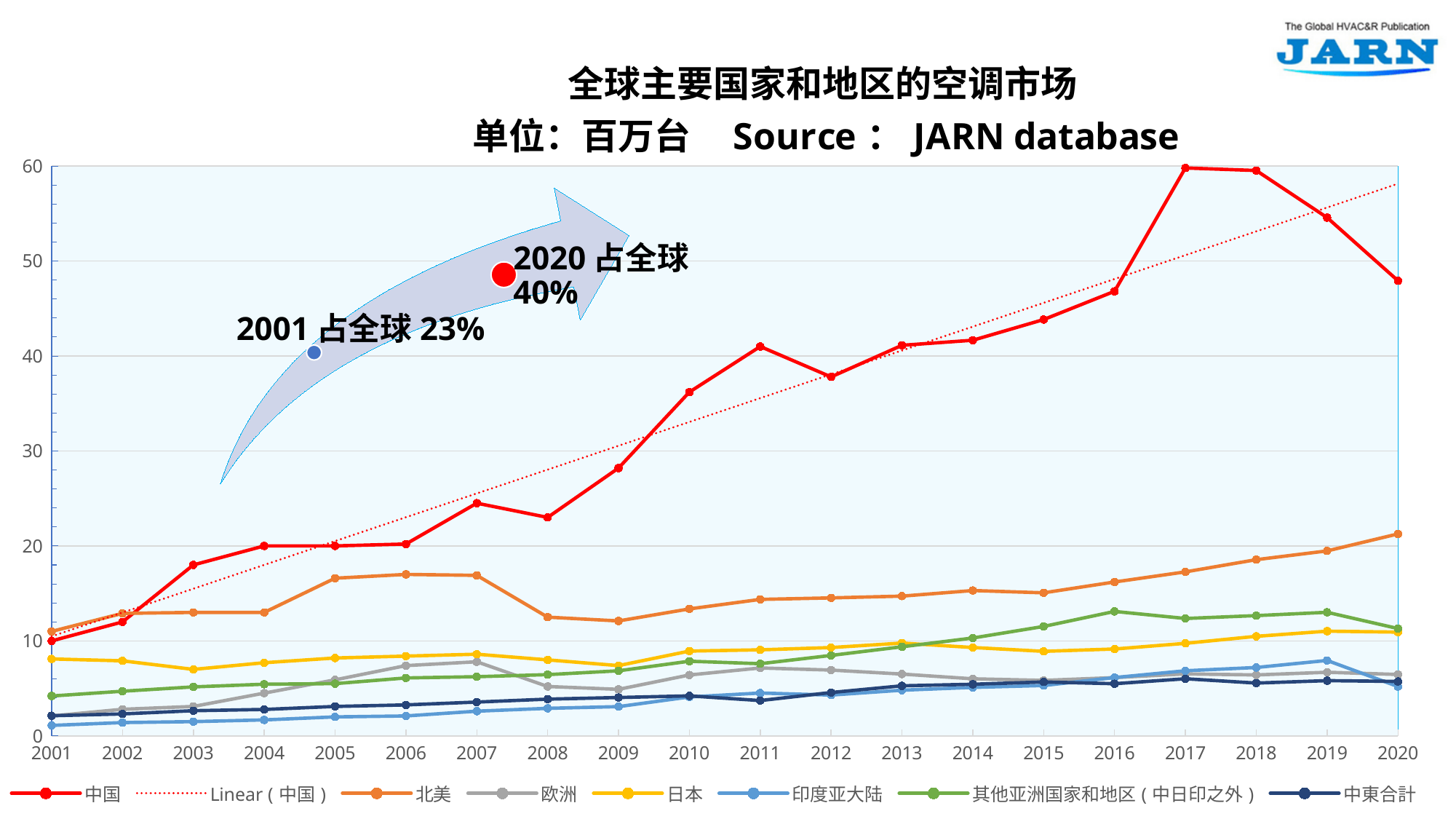
Is the value for 北美 in 2020 greater or less than 20? greater How many years are plotted along the x axis? 20 How many entries does the legend list? 8 What kind of chart is shown on the slide? line chart According to the annotation, what share of the global market did China hold in 2020? 40% Is the value for 中国 in 2010 greater or less than 30? greater Which series has the highest value in 2020? 中国 In 2020, which is larger, the value for 中国 or the value for 北美? 中国 Is the value for 中国 in 2020 greater or less than 40? greater Which series has the lowest value in 2001? 印度亚大陆 Does the value for 北美 rise or fall from 2013 to 2020? rise